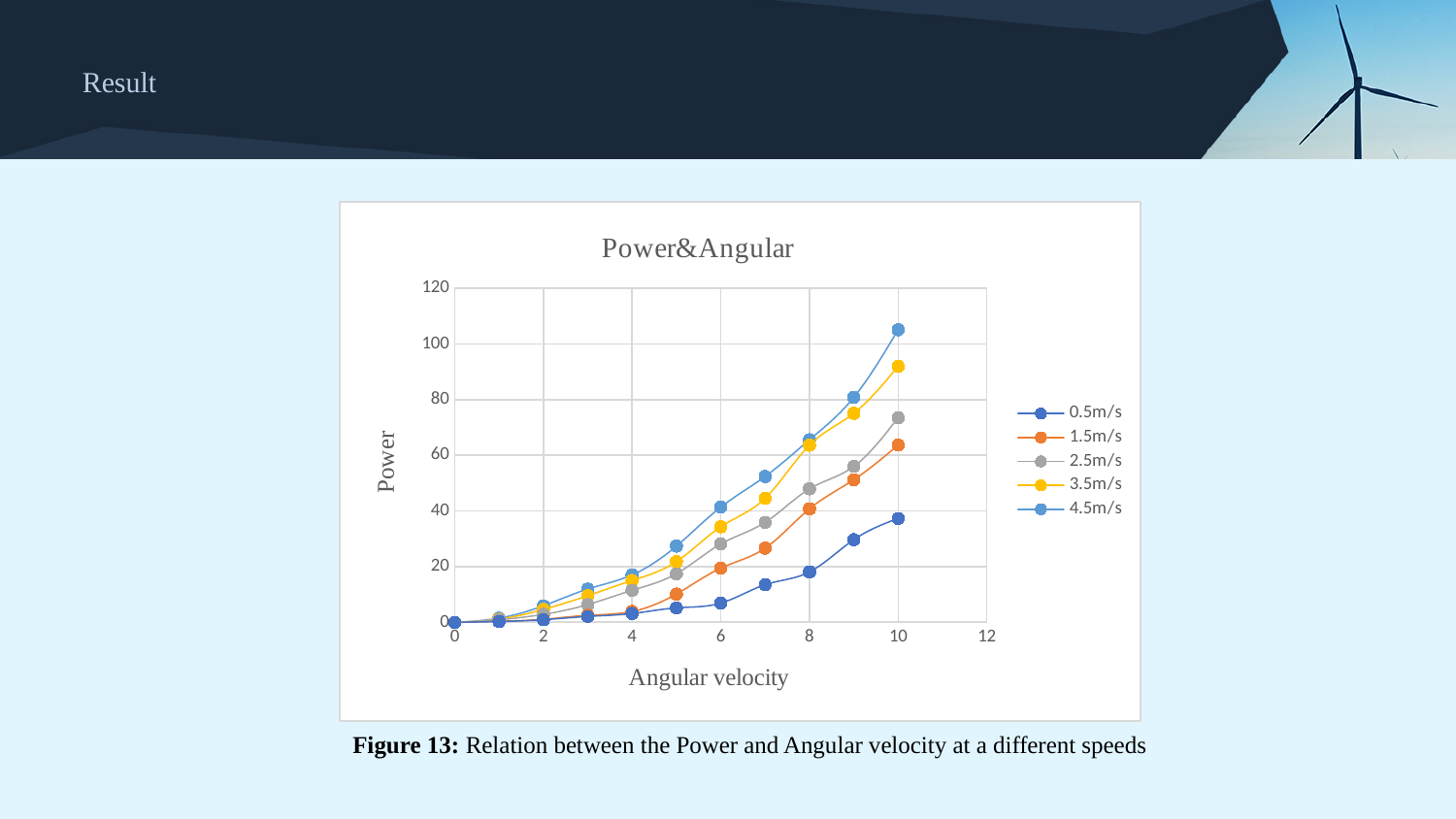
Does the power for the 4.5m/s series rise or fall as angular velocity increases? rise What kind of chart is shown on the slide? line chart Which series reaches the highest power at an angular velocity of 10? 4.5m/s How many data points are plotted for the 4.5m/s series? 11 Is the power for the 0.5m/s series at an angular velocity of 10 greater or less than 40? less At an angular velocity of 8, which series has the higher power: 2.5m/s or 1.5m/s? 2.5m/s Is the power for the 3.5m/s series at an angular velocity of 10 greater or less than 80? greater What is the label of the x axis of the chart? Angular velocity What is the title of the chart? Power&Angular How many series does the legend of the Power&Angular chart list? 5 Is the power for the 4.5m/s series at an angular velocity of 10 greater or less than 100? greater Which series has the lowest power at an angular velocity of 10? 0.5m/s